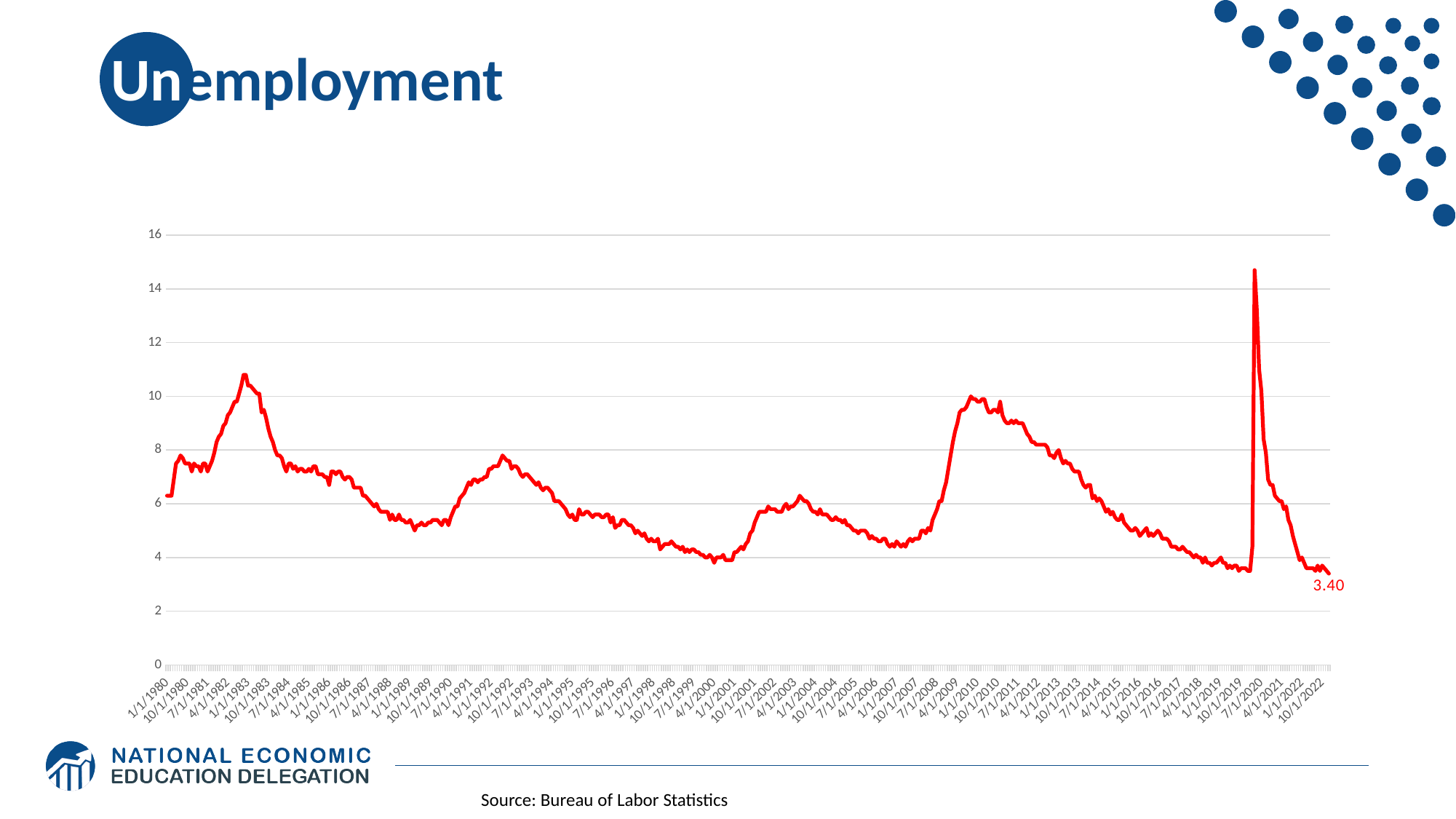
In which year does the line reach its highest point? 2020 Is the value at 1/1/2000 greater or less than 6? less What kind of chart is shown on the slide? line chart Between 1/1/1980 and 1/1/1983, does the line generally rise or fall? rise What is the source cited below the chart? Bureau of Labor Statistics What is the value shown by the data label at the end of the line? 3.40 Is the value at 1/1/2010 greater or less than 8? greater Between 1/1/2010 and 1/1/2019, does the line generally rise or fall? fall Is the value at the peak around 1/1/1983 greater or less than 10? greater How many lines are plotted on the chart? 1